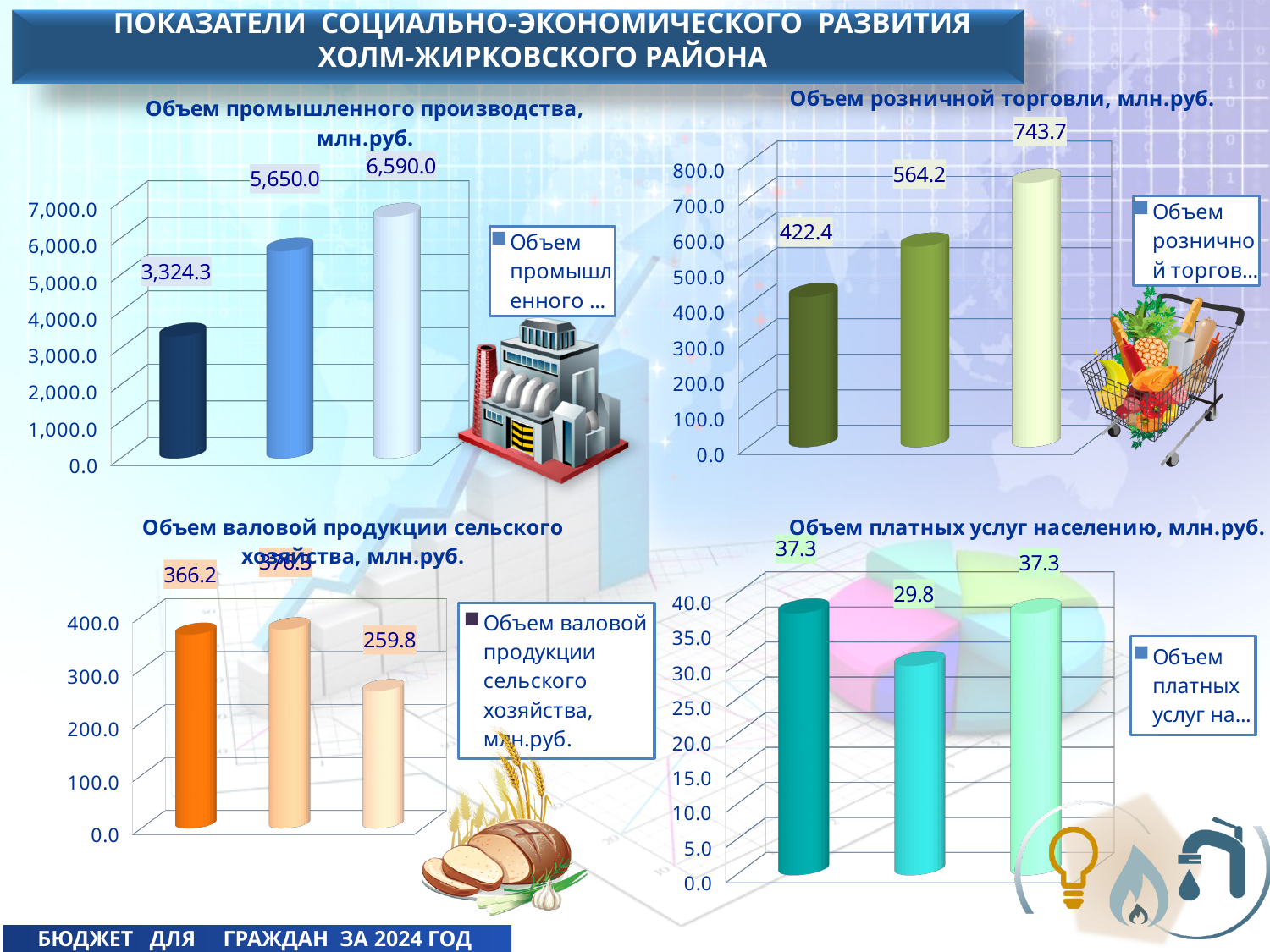
In the chart 'Объем валовой продукции сельского хозяйства, млн.руб.', what is the value of the third (rightmost) bar? 259.8 In the chart 'Объем промышленного производства, млн.руб.', what is the value of the first (leftmost) bar? 3,324.3 In the chart 'Объем промышленного производства, млн.руб.', do the values rise or fall from left to right? rise What type of chart is 'Объем платных услуг населению, млн.руб.'? bar chart In the chart 'Объем розничной торговли, млн.руб.', what is the difference between the third bar and the second bar? 179.5 How many bars are shown in the chart 'Объем розничной торговли, млн.руб.'? 3 In the chart 'Объем валовой продукции сельского хозяйства, млн.руб.', which is larger, the first bar or the third bar? the first bar (366.2) In the chart 'Объем розничной торговли, млн.руб.', what is the value of the second bar? 564.2 In the chart 'Объем промышленного производства, млн.руб.', what is the difference between the third bar and the first bar? 3,265.7 In the chart 'Объем платных услуг населению, млн.руб.', which bar has the lowest value? the second (middle) bar, 29.8 In the chart 'Объем промышленного производства, млн.руб.', what is the value of the third (rightmost) bar? 6,590.0 In the chart 'Объем розничной торговли, млн.руб.', which bar has the highest value? the third (rightmost) bar, 743.7